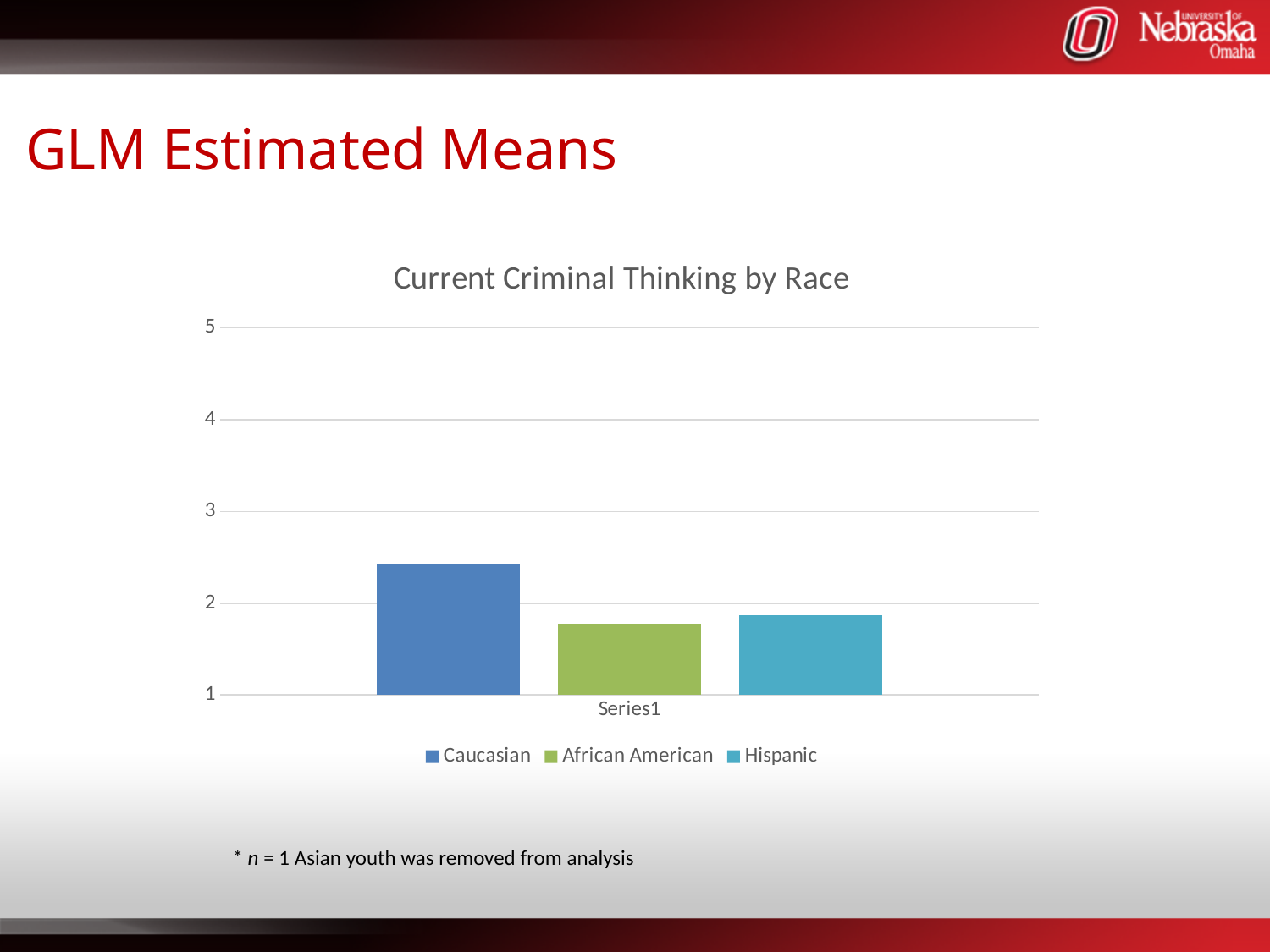
Is the value for Hispanic greater or less than 2? less Which group has the highest value in the chart? Caucasian How many entries does the chart's legend list? 3 Is the value for Caucasian greater or less than 2? greater How many bars are plotted in the chart? 3 Is the value for Caucasian greater or less than 3? less Which is larger, the value for Caucasian or the value for Hispanic? Caucasian What label appears on the x axis beneath the bars? Series1 What kind of chart is shown on the slide? bar chart Which is larger, the value for Caucasian or the value for African American? Caucasian What is the title of the chart? Current Criminal Thinking by Race